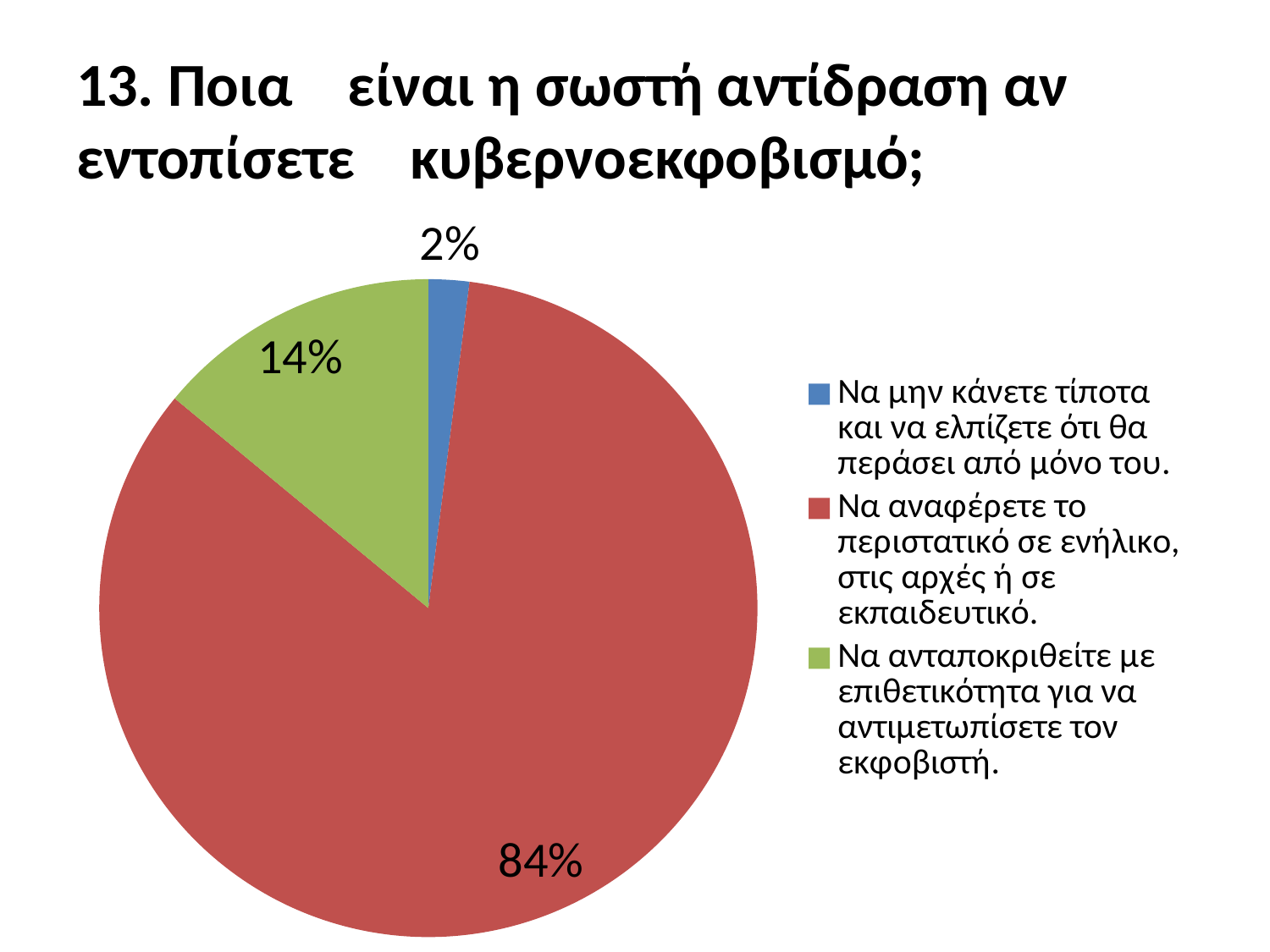
Which response has the smallest share of the pie? Να μην κάνετε τίποτα και να ελπίζετε ότι θα περάσει από μόνο του. How many slices does the pie chart have? 3 What percentage of the pie corresponds to "Να μην κάνετε τίποτα και να ελπίζετε ότι θα περάσει από μόνο του."? 2% What percentage of the pie corresponds to "Να ανταποκριθείτε με επιθετικότητα για να αντιμετωπίσετε τον εκφοβιστή."? 14% Which response has the largest share of the pie? Να αναφέρετε το περιστατικό σε ενήλικο, στις αρχές ή σε εκπαιδευτικό. What kind of chart is shown on the slide? Pie chart What is the difference in percentage points between the 84% slice and the 14% slice? 70 Which is larger: the share for "Να ανταποκριθείτε με επιθετικότητα..." or the share for "Να μην κάνετε τίποτα..."? Να ανταποκριθείτε με επιθετικότητα για να αντιμετωπίσετε τον εκφοβιστή. What is the difference in percentage points between the 14% slice and the 2% slice? 12 How many entries does the legend list? 3 What colour is the slice representing 84%? Red What percentage of the pie corresponds to "Να αναφέρετε το περιστατικό σε ενήλικο, στις αρχές ή σε εκπαιδευτικό."? 84%